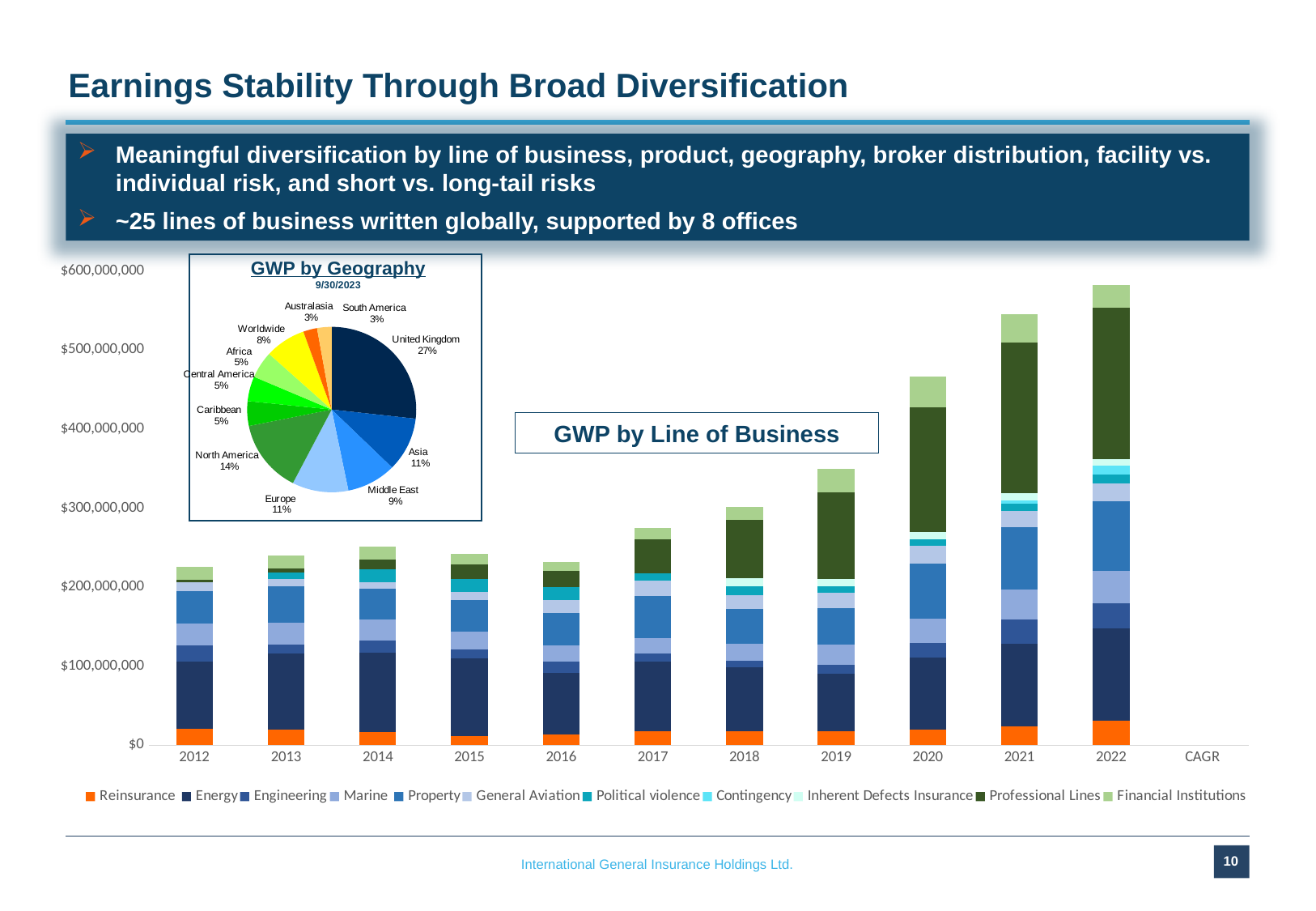
In the GWP by Geography pie chart, what share does the United Kingdom account for? 27% What kind of chart is the GWP by Line of Business chart? Stacked bar chart In the GWP by Line of Business chart, which year has the highest total GWP? 2022 In the GWP by Line of Business chart, is the total for 2022 greater or less than $500,000,000? greater In the GWP by Geography pie chart, how many regions are shown? 11 In the GWP by Geography pie chart, what is the difference in percentage points between the United Kingdom and Asia shares? 16 percentage points In the GWP by Geography pie chart, which region has the largest share? United Kingdom In the GWP by Geography pie chart, what share does North America account for? 14% In the GWP by Geography pie chart, what share does Worldwide account for? 8% In the GWP by Line of Business chart, how many series does the legend list? 11 In the GWP by Geography pie chart, which is larger, the share for Europe or the share for Middle East? Europe